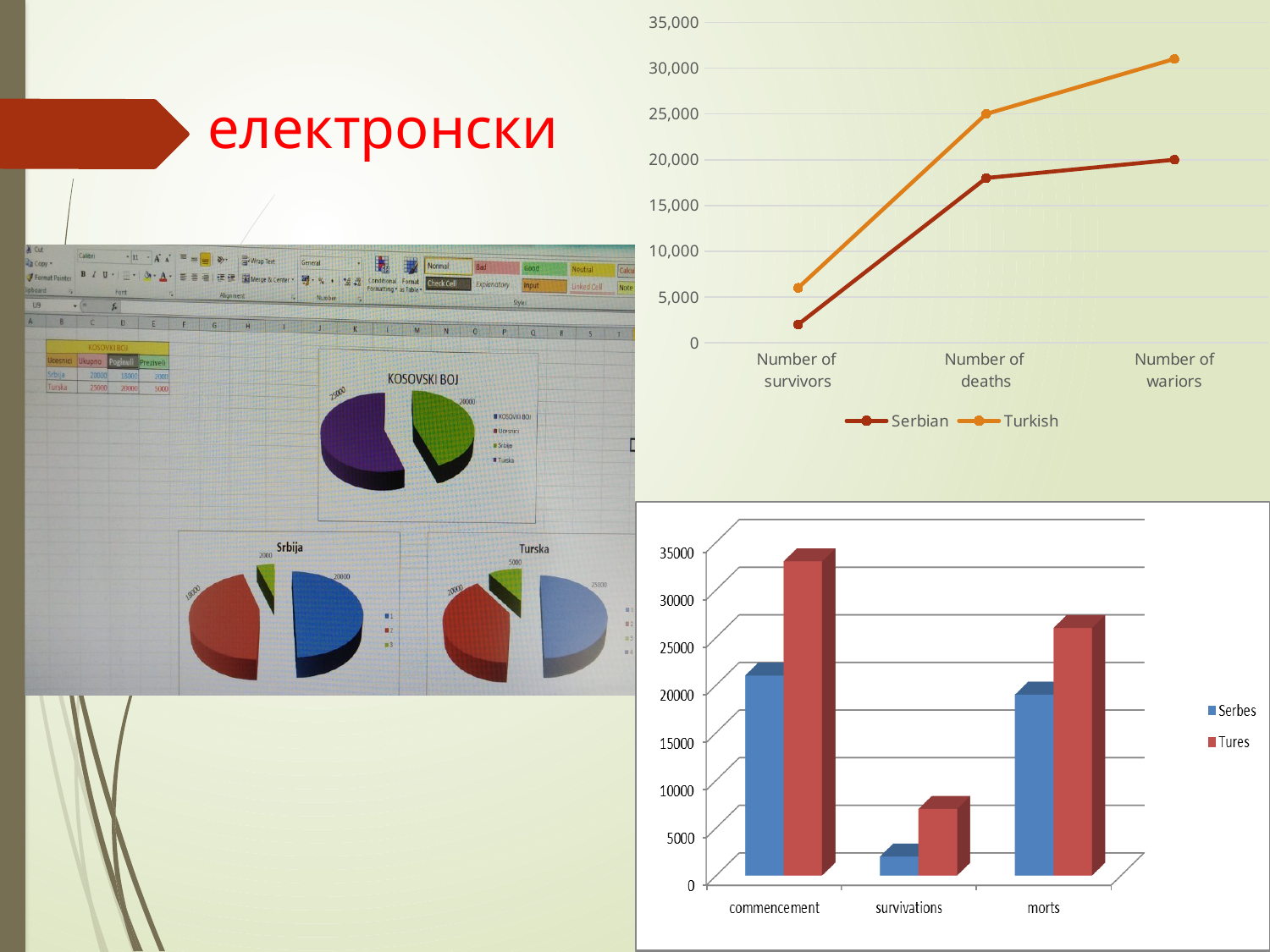
What kind of chart is the top-right chart with the Serbian and Turkish legend? line chart In the bottom-right bar chart, what are the two legend entries? Serbes and Tures What kind of chart is the bottom-right chart with the Serbes and Tures legend? bar chart In the top-right line chart, is the Turkish value for Number of wariors greater or less than 30,000? greater In the top-right line chart, how many categories are shown on the x axis? 3 In the top-right line chart, is the Serbian value for Number of survivors greater or less than 5,000? less In the bottom-right bar chart, which series is taller for commencement, Serbes or Tures? Tures In the top-right line chart, how many series does the legend list? 2 In the top-right line chart, do the Serbian values rise or fall from Number of survivors to Number of wariors? rise In the top-right line chart, which series is higher for Number of deaths, Serbian or Turkish? Turkish In the bottom-right bar chart, is the Tures value for morts greater or less than 25000? greater In the bottom-right bar chart, which category has the lowest values for both series? survivations